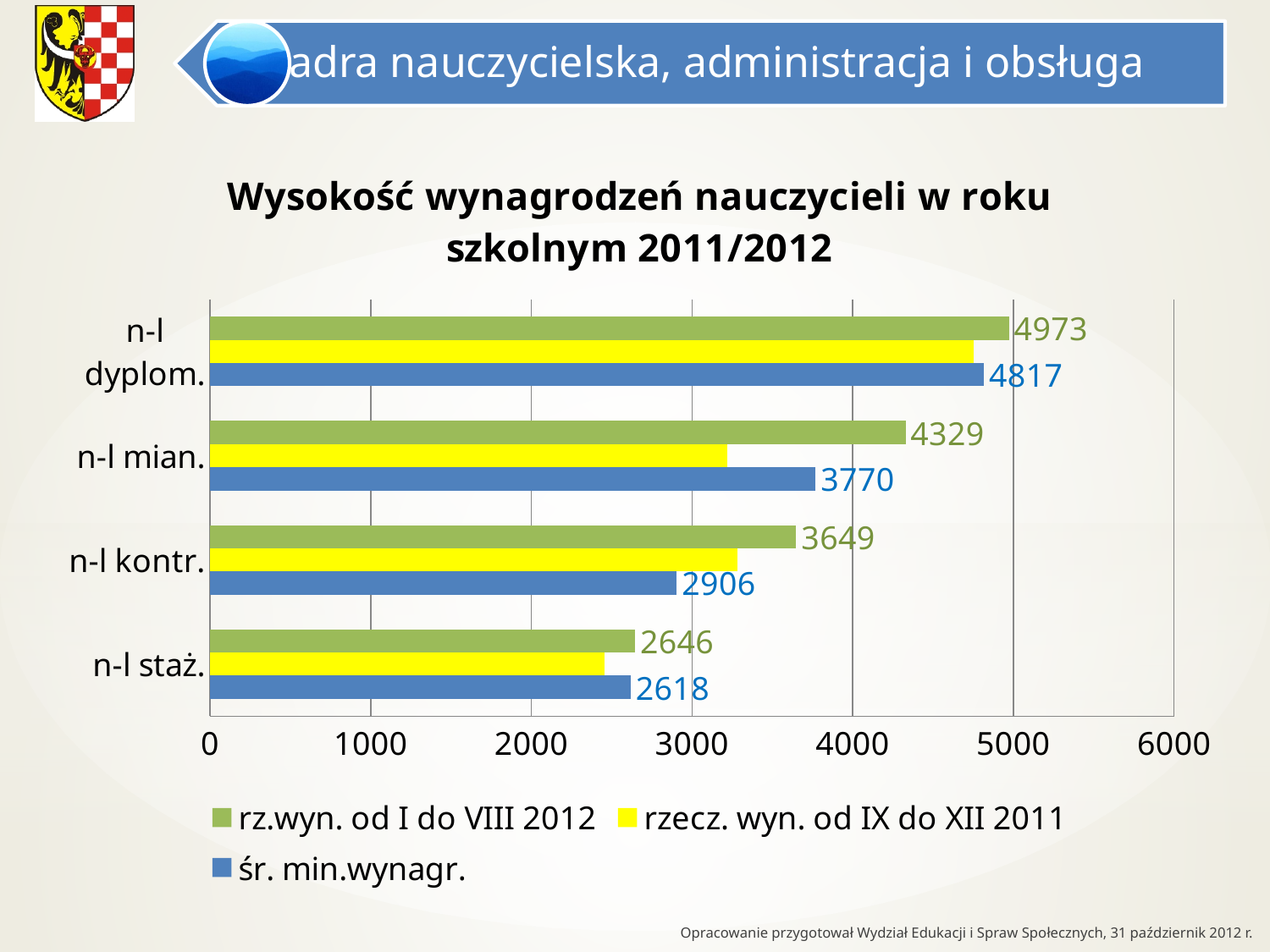
How many categories are shown on the chart? 4 What kind of chart is shown on the slide? bar chart What is the value of 'śr. min.wynagr.' for n-l staż.? 2618 Is the value of 'rzecz. wyn. od IX do XII 2011' for n-l mian. greater or less than 4000? less Which is larger for n-l kontr.: 'rz.wyn. od I do VIII 2012' or 'śr. min.wynagr.'? rz.wyn. od I do VIII 2012 What is the value of 'śr. min.wynagr.' for n-l mian.? 3770 What is the value of 'rz.wyn. od I do VIII 2012' for n-l kontr.? 3649 Which category has the highest value for 'rz.wyn. od I do VIII 2012'? n-l dyplom. How many series does the legend list? 3 What is the value of 'rz.wyn. od I do VIII 2012' for n-l dyplom.? 4973 What is the difference between 'rz.wyn. od I do VIII 2012' and 'śr. min.wynagr.' for n-l mian.? 559 Which category has the lowest value for 'śr. min.wynagr.'? n-l staż.